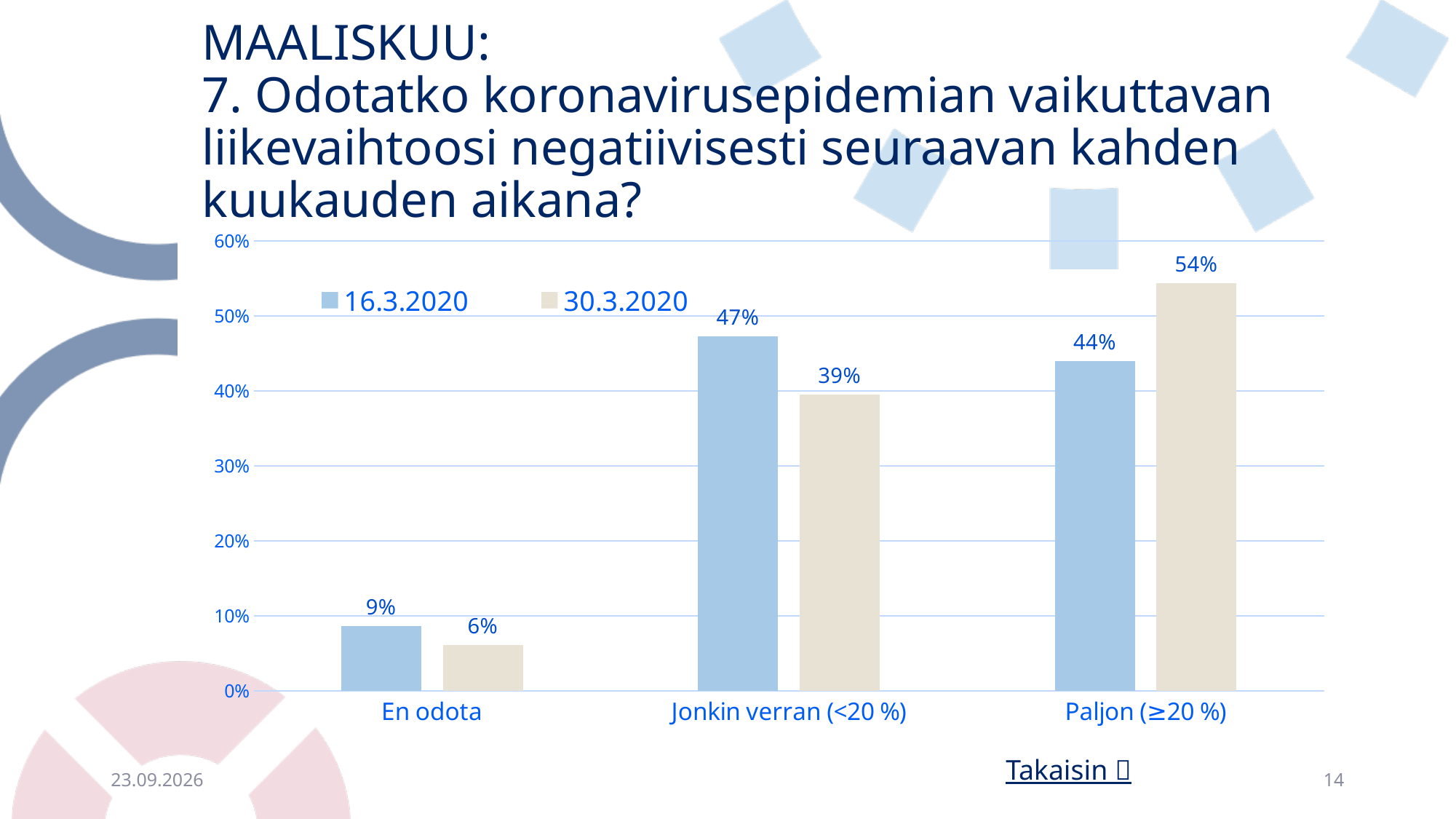
What is the value for "Paljon (≥20 %)" in the 16.3.2020 series? 44% What are the two series names listed in the legend? 16.3.2020 and 30.3.2020 What kind of chart is shown on the slide? Bar chart What is the difference between the 30.3.2020 and 16.3.2020 values for "Paljon (≥20 %)"? 10% What is the value for "Jonkin verran (<20 %)" in the 30.3.2020 series? 39% For "Jonkin verran (<20 %)", which series has the larger value, 16.3.2020 or 30.3.2020? 16.3.2020 How many categories are shown on the x axis? 3 What is the value for "En odota" in the 16.3.2020 series? 9% What is the value for "Paljon (≥20 %)" in the 30.3.2020 series? 54% How many series does the legend list? 2 Which category has the lowest value in the 30.3.2020 series? En odota Which category has the highest value in the 16.3.2020 series? Jonkin verran (<20 %)